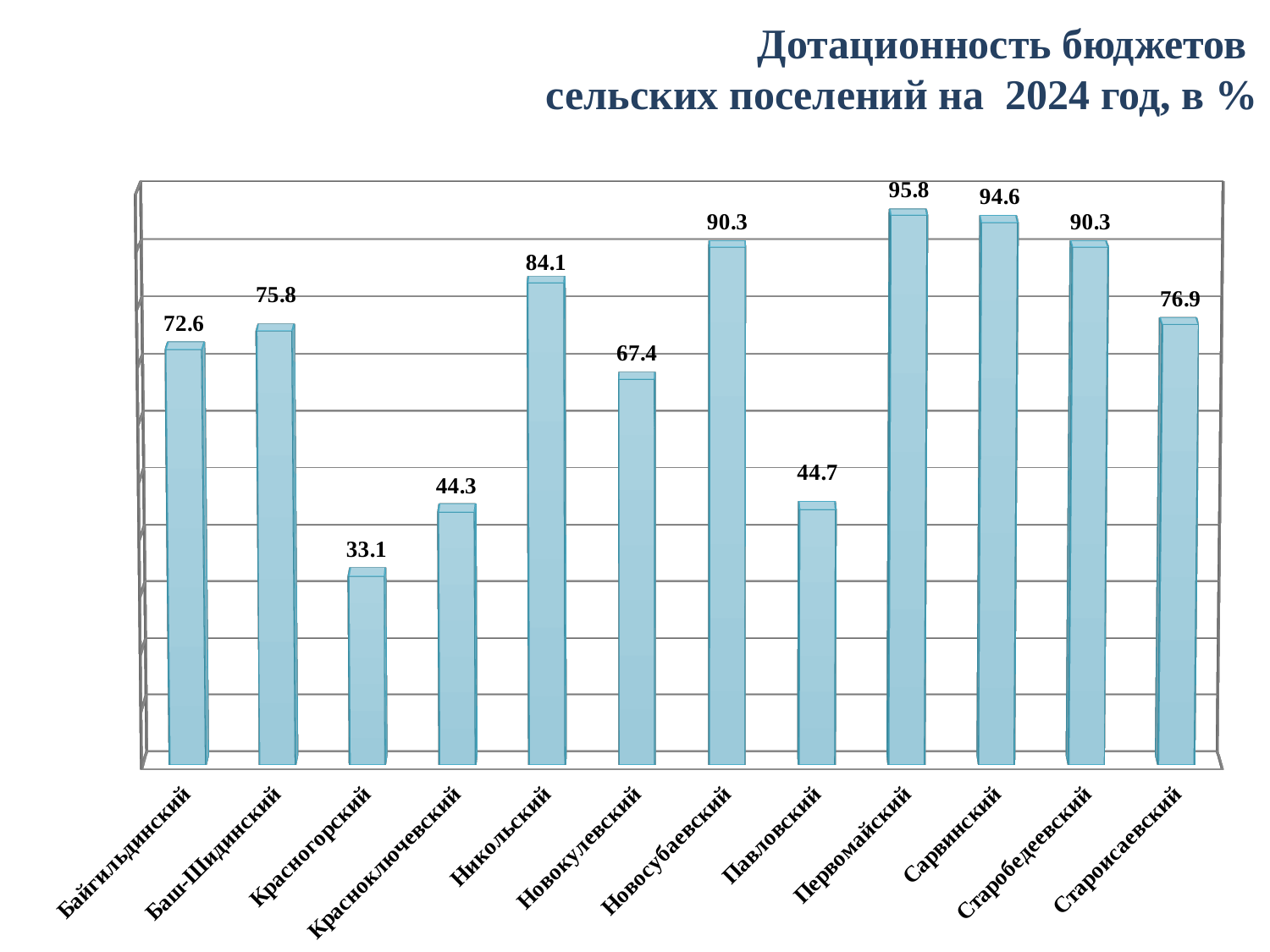
Which category has the highest value? Первомайский What is the value for Староисаевский? 76.9 What kind of chart is shown on the slide? Bar chart Which is larger, the value for Павловский or the value for Красноключевский? Павловский What is the title of the chart? Дотационность бюджетов сельских поселений на 2024 год, в % What is the value for Красногорский? 33.1 What is the difference between the values for Первомайский and Красногорский? 62.7 What is the value for Байгильдинский? 72.6 What is the difference between the values for Никольский and Баш-Шидинский? 8.3 How many categories are shown in the chart? 12 What is the value for Новокулевский? 67.4 Which category has the lowest value? Красногорский